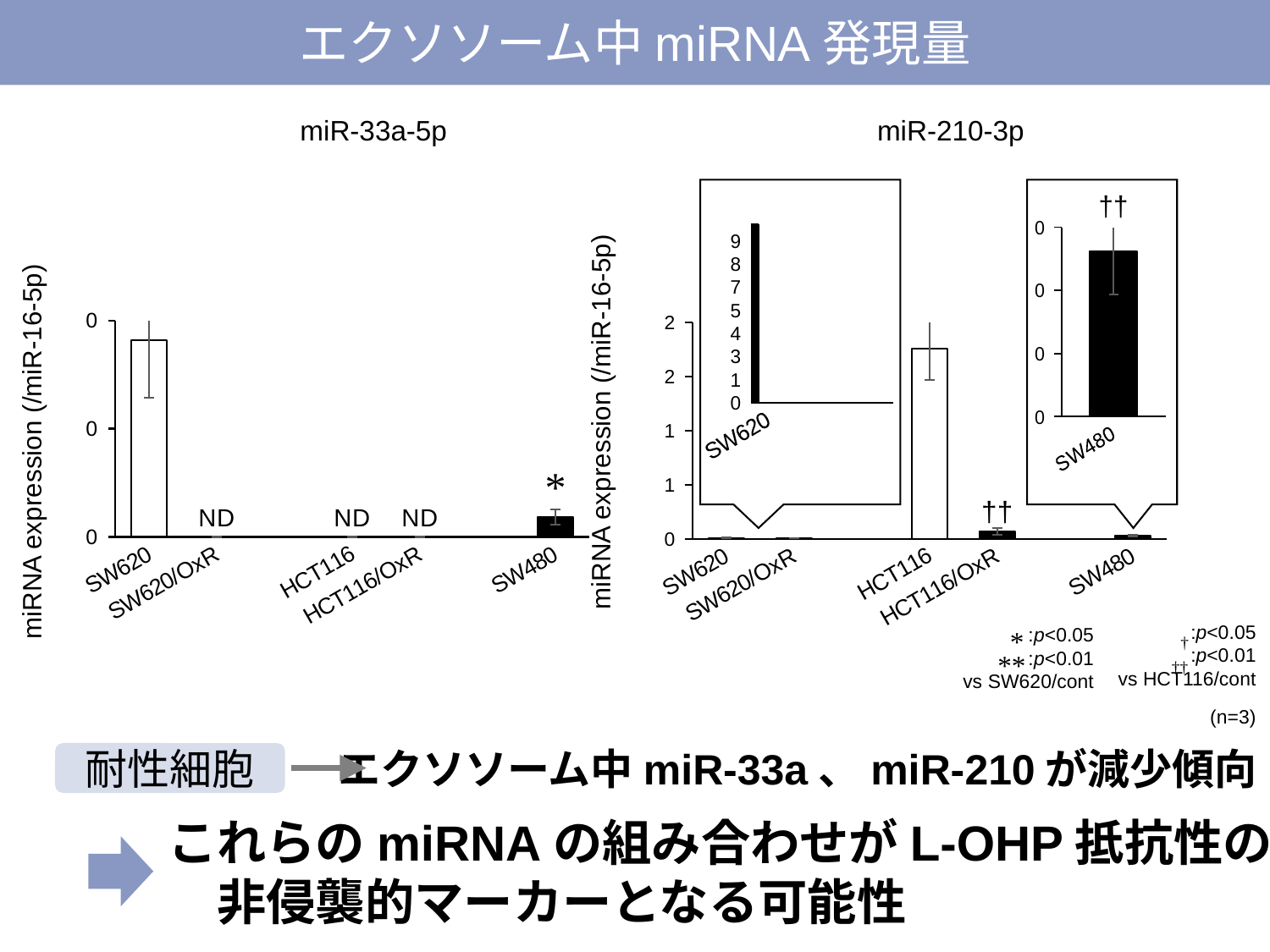
How many categories are shown on the x axis of the miR-210-3p chart? 5 In the miR-33a-5p chart, how many categories are marked ND? 3 In the miR-210-3p chart, which is larger, the value for HCT116 or the value for HCT116/OxR? HCT116 In the miR-33a-5p chart, which category is marked with an asterisk (*)? SW480 In the miR-33a-5p chart, which category has the highest value? SW620 In the miR-210-3p chart, which category has the highest value? HCT116 What is the y-axis label of the miR-210-3p chart? miRNA expression (/miR-16-5p) In the miR-33a-5p chart, which is larger, the value for SW620 or the value for SW480? SW620 In the miR-210-3p chart, is the value for HCT116/OxR greater or less than 1? less What sample size (n) is stated on the slide for the charts? n=3 What kind of chart is the miR-33a-5p chart? bar chart In the miR-33a-5p chart, which categories are marked ND? SW620/OxR, HCT116, HCT116/OxR